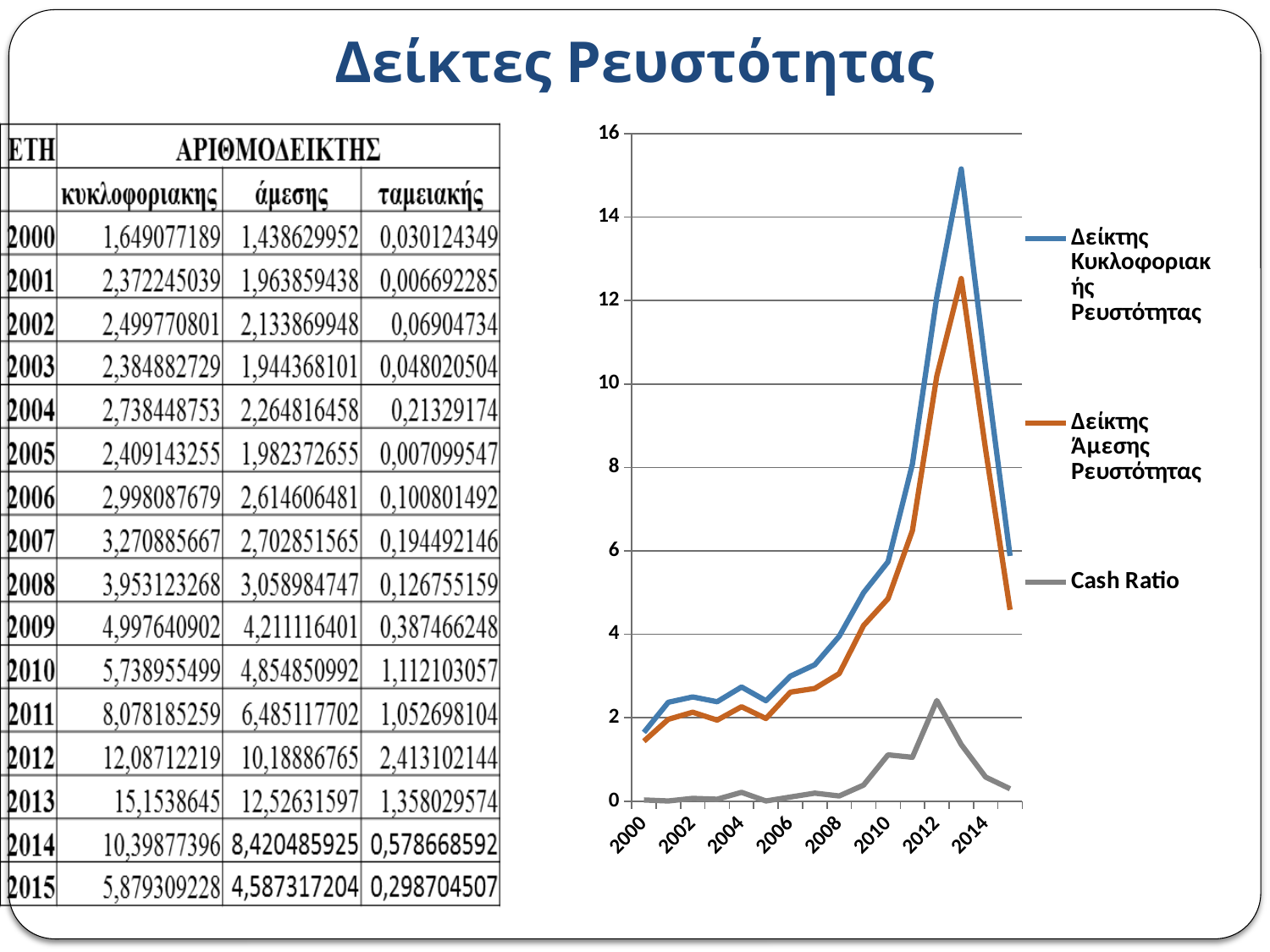
In which year does the Δείκτης Κυκλοφοριακής Ρευστότητας line reach its highest value? 2013 Is the value of Δείκτης Κυκλοφοριακής Ρευστότητας in 2013 greater or less than 14? greater How many series does the chart's legend list? 3 How many years are plotted along the x axis of the chart? 16 Is the Cash Ratio value in 2012 greater or less than 2? greater What kind of chart is shown on the slide? line chart According to the table on the slide, what is the κυκλοφοριακής ratio for 2013? 15,1538645 What colour is the Cash Ratio line in the chart? grey In 2013, which is larger: Δείκτης Κυκλοφοριακής Ρευστότητας or Δείκτης Άμεσης Ρευστότητας? Δείκτης Κυκλοφοριακής Ρευστότητας Is the value of Δείκτης Άμεσης Ρευστότητας in 2015 greater or less than 6? less Do the values of Δείκτης Κυκλοφοριακής Ρευστότητας rise or fall from 2013 to 2015? fall In which year does the Cash Ratio line reach its highest value? 2012